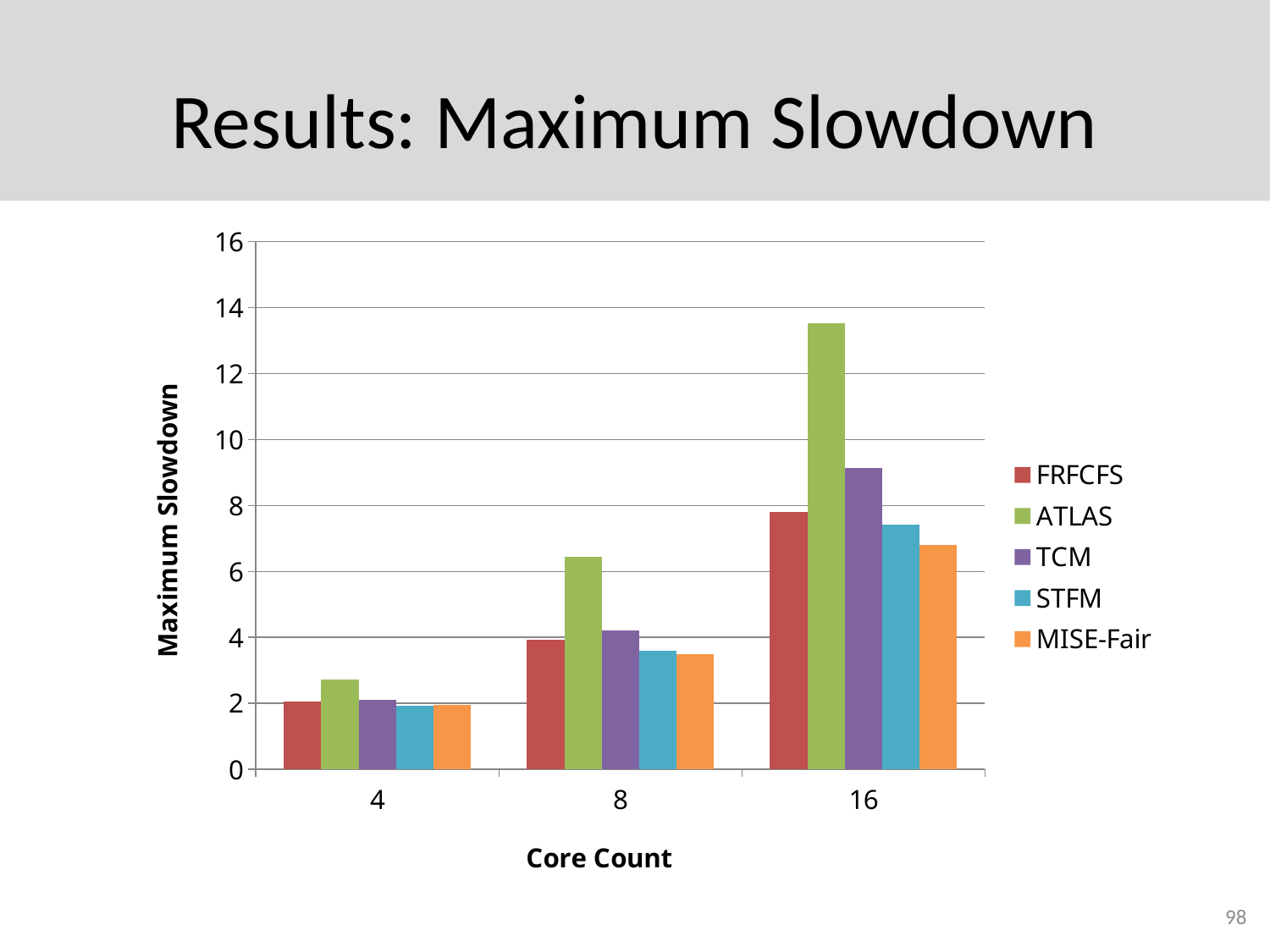
What is the label of the y axis? Maximum Slowdown Is the value for MISE-Fair at a core count of 8 greater or less than 4? less Which series has the lowest maximum slowdown at a core count of 16? MISE-Fair How many series does the legend list? 5 Does the maximum slowdown for ATLAS rise or fall as the core count increases from 4 to 16? rise Which series has the highest maximum slowdown at a core count of 8? ATLAS Is the value for ATLAS at a core count of 16 greater or less than 12? greater Which series has the highest maximum slowdown at a core count of 16? ATLAS How many core count categories are shown on the x axis? 3 At a core count of 16, which is larger: the value for FRFCFS or the value for MISE-Fair? FRFCFS What kind of chart is shown on the slide? bar chart Is the value for TCM at a core count of 16 greater or less than 8? greater